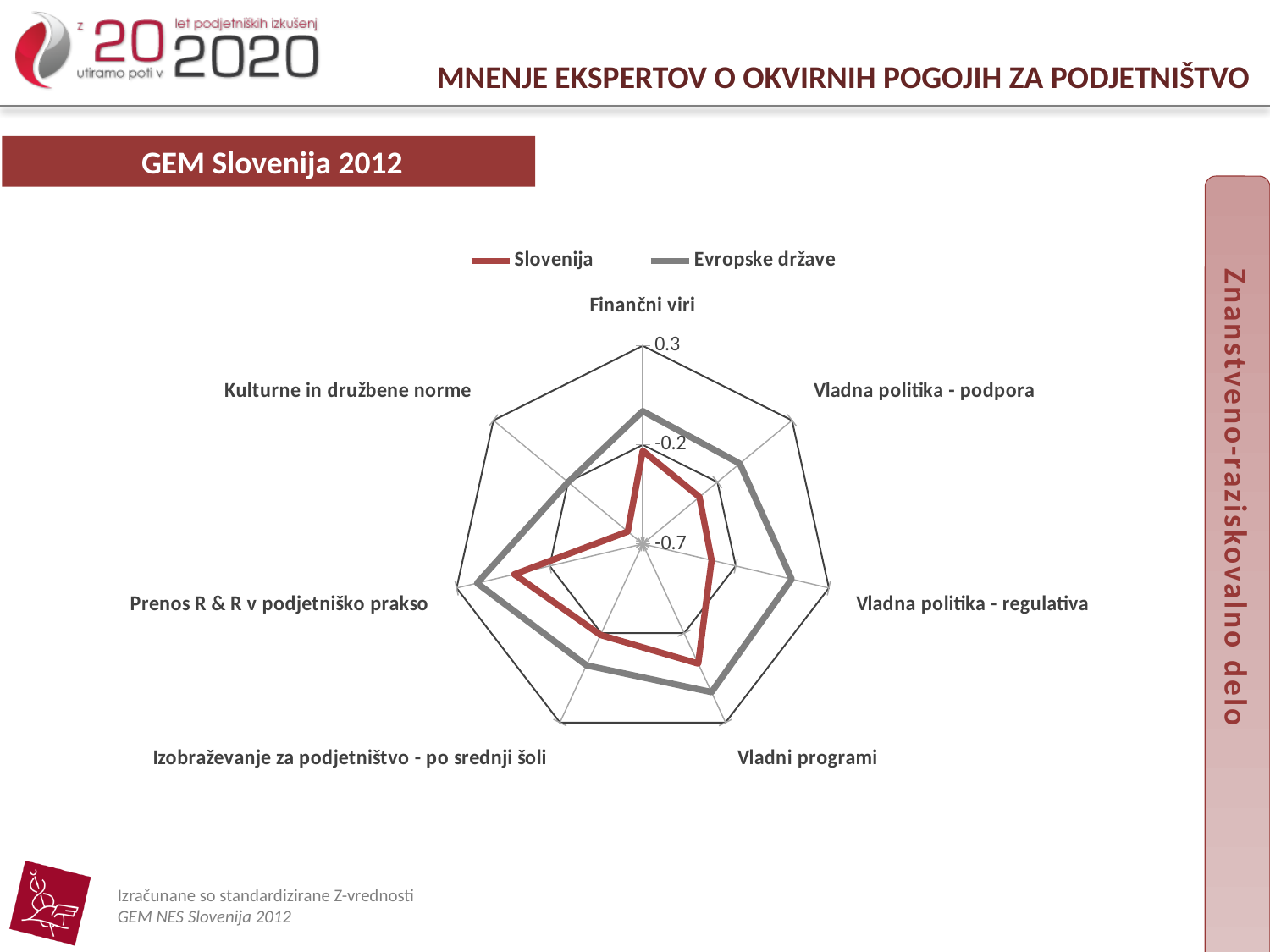
For Finančni viri, which series has the higher value, Slovenija or Evropske države? Evropske države How many categories (axes) does the radar chart have? 7 Is the Evropske države value for Prenos R & R v podjetniško prakso greater or less than -0.2? greater For Vladni programi, which series has the higher value, Slovenija or Evropske države? Evropske države For the Slovenija series, which category has the lowest value? Kulturne in družbene norme What is the title shown above the chart? GEM Slovenija 2012 Is the Slovenija value for Vladni programi greater or less than -0.2? greater For Kulturne in družbene norme, which series has the higher value, Slovenija or Evropske države? Evropske države What kind of chart is shown on the slide? Radar chart Is the Slovenija value for Kulturne in družbene norme greater or less than -0.2? less Which two series are listed in the chart legend? Slovenija and Evropske države How many series does the chart legend list? 2